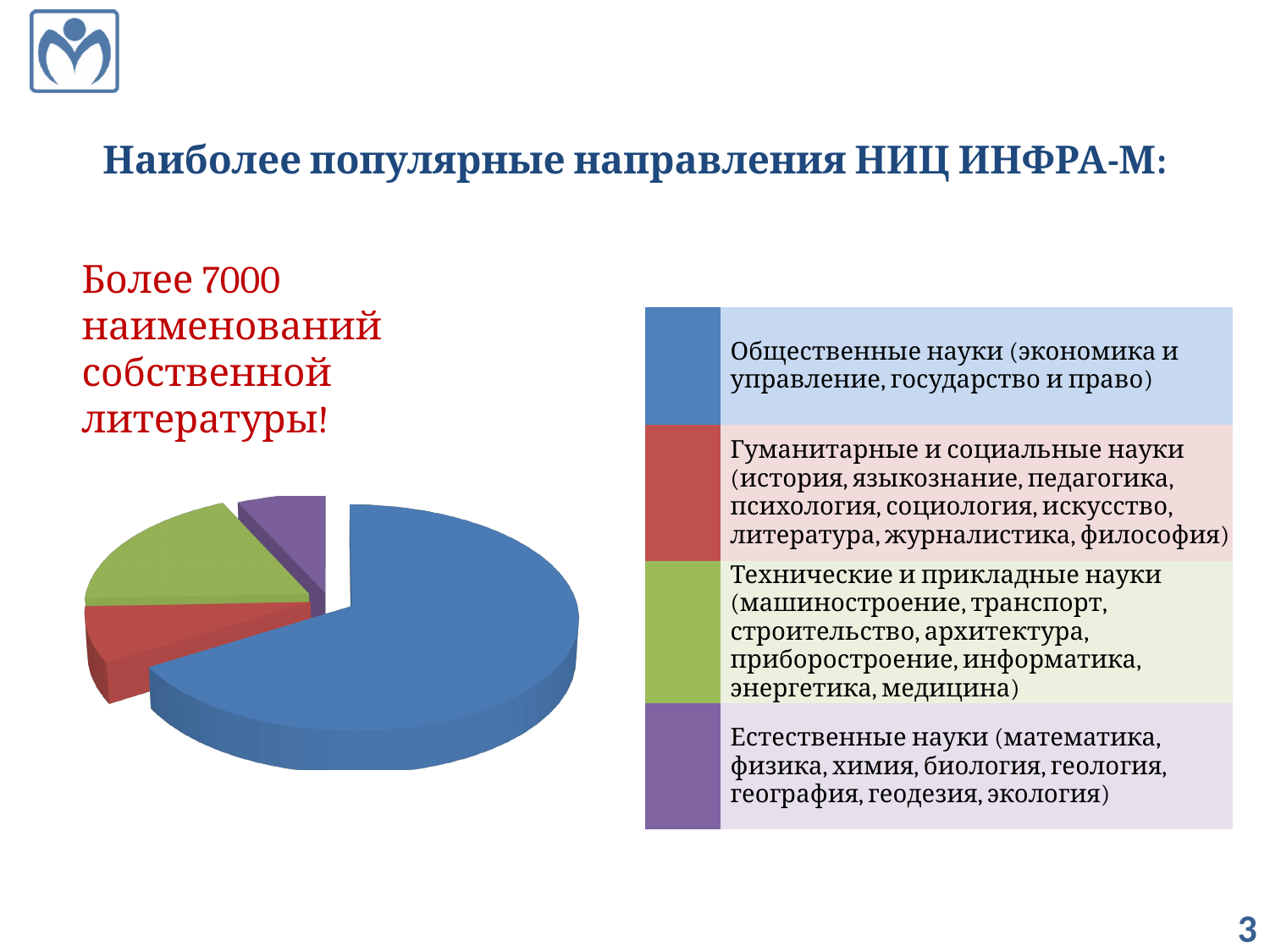
Which slice is larger: Общественные науки or Гуманитарные и социальные науки? Общественные науки Which category has the smallest slice of the pie chart? Естественные науки (математика, физика, химия, биология, геология, география, геодезия, экология) Which slice is larger: Общественные науки or Технические и прикладные науки? Общественные науки How many categories does the legend of the pie chart list? 4 What kind of chart is shown on the slide? pie chart What colour is the slice for Технические и прикладные науки in the pie chart? green How many slices does the pie chart have? 4 Which category has the largest slice of the pie chart? Общественные науки (экономика и управление, государство и право) What colour is the slice for Гуманитарные и социальные науки in the pie chart? red Which slice is larger: Технические и прикладные науки or Естественные науки? Технические и прикладные науки